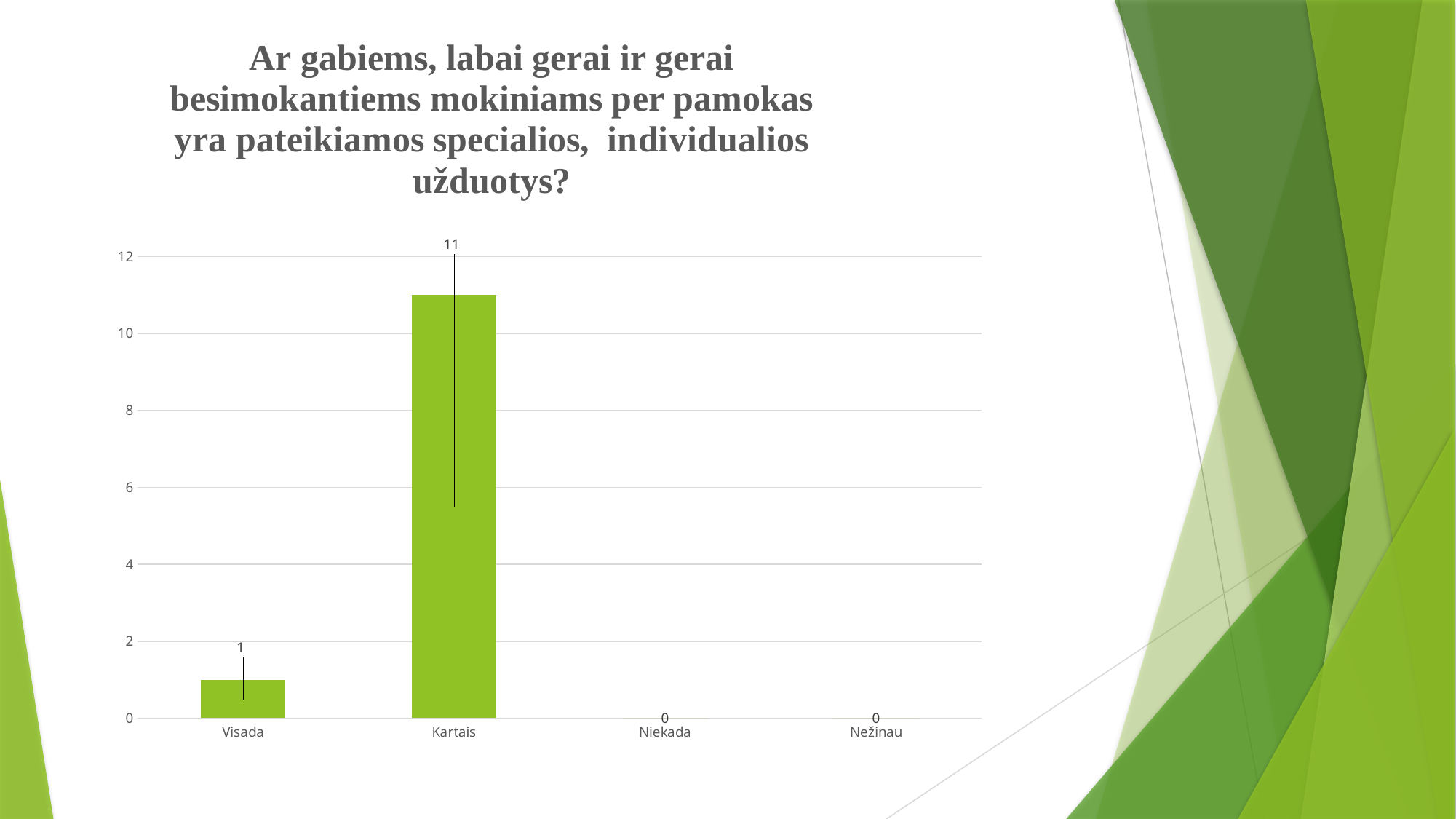
Which category has the highest value? Kartais How many categories are shown on the x axis? 4 What is the total of all four category values? 12 What is the value for Visada? 1 Is the value for Kartais greater or less than 10? greater What is the value for Niekada? 0 What is the difference between the values for Kartais and Visada? 10 What is the value for Kartais? 11 What colour are the bars in the chart? green Which is larger, the value for Visada or the value for Kartais? Kartais What is the value for Nežinau? 0 What kind of chart is shown on the slide? bar chart